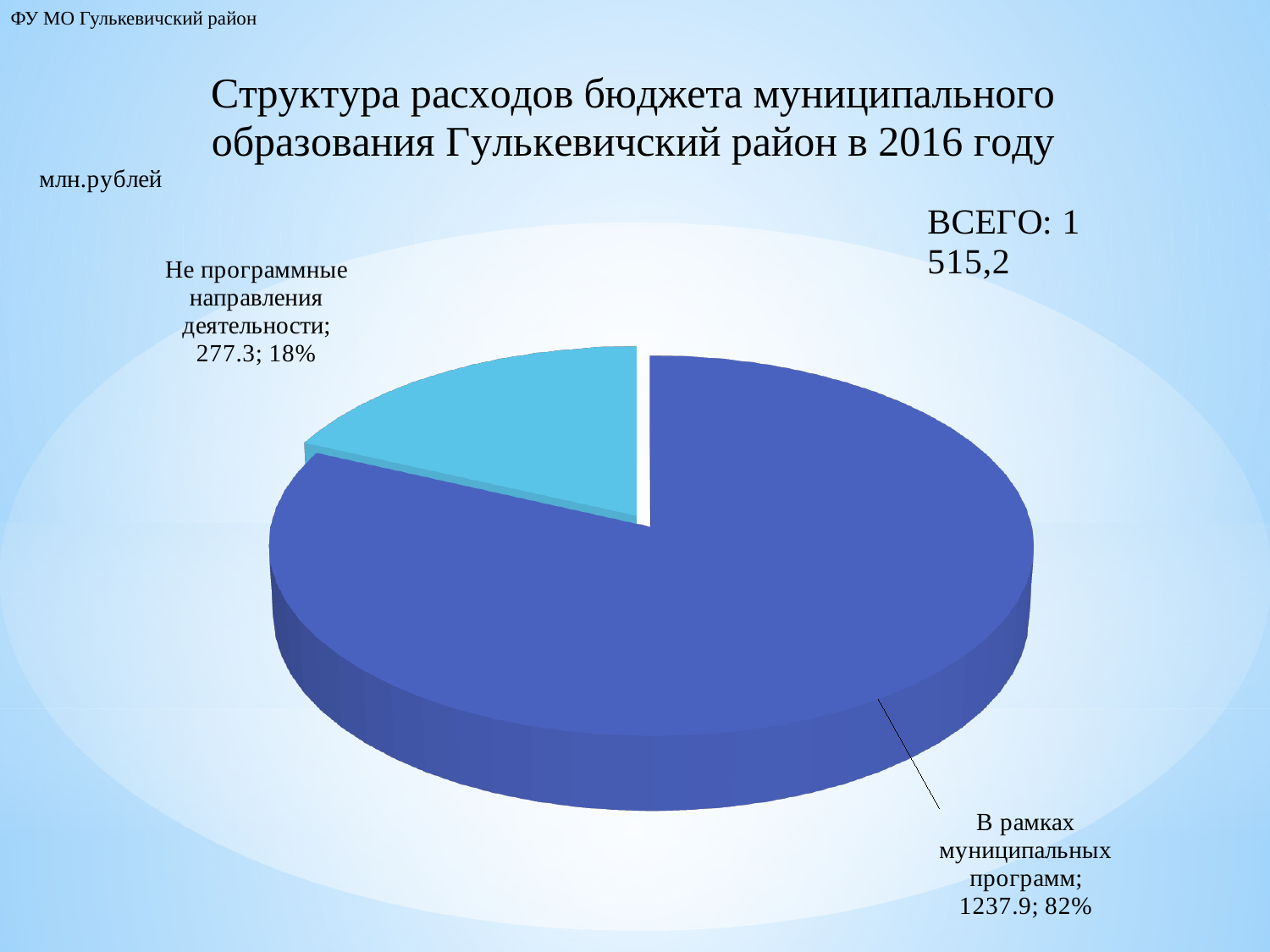
What share of the pie does "В рамках муниципальных программ" represent? 82% How many slices does the pie chart have? 2 Which slice is the largest? В рамках муниципальных программ In what units are the values on the chart given? млн.рублей What share of the pie does "Не программные направления деятельности" represent? 18% What is the value for "В рамках муниципальных программ"? 1237.9 Which is larger: "В рамках муниципальных программ" or "Не программные направления деятельности"? В рамках муниципальных программ Which slice is the smallest? Не программные направления деятельности What kind of chart is shown on the slide? Pie chart What is the difference between the values for "В рамках муниципальных программ" and "Не программные направления деятельности"? 960.6 What total (ВСЕГО) is shown on the slide? 1 515,2 What is the value for "Не программные направления деятельности"? 277.3